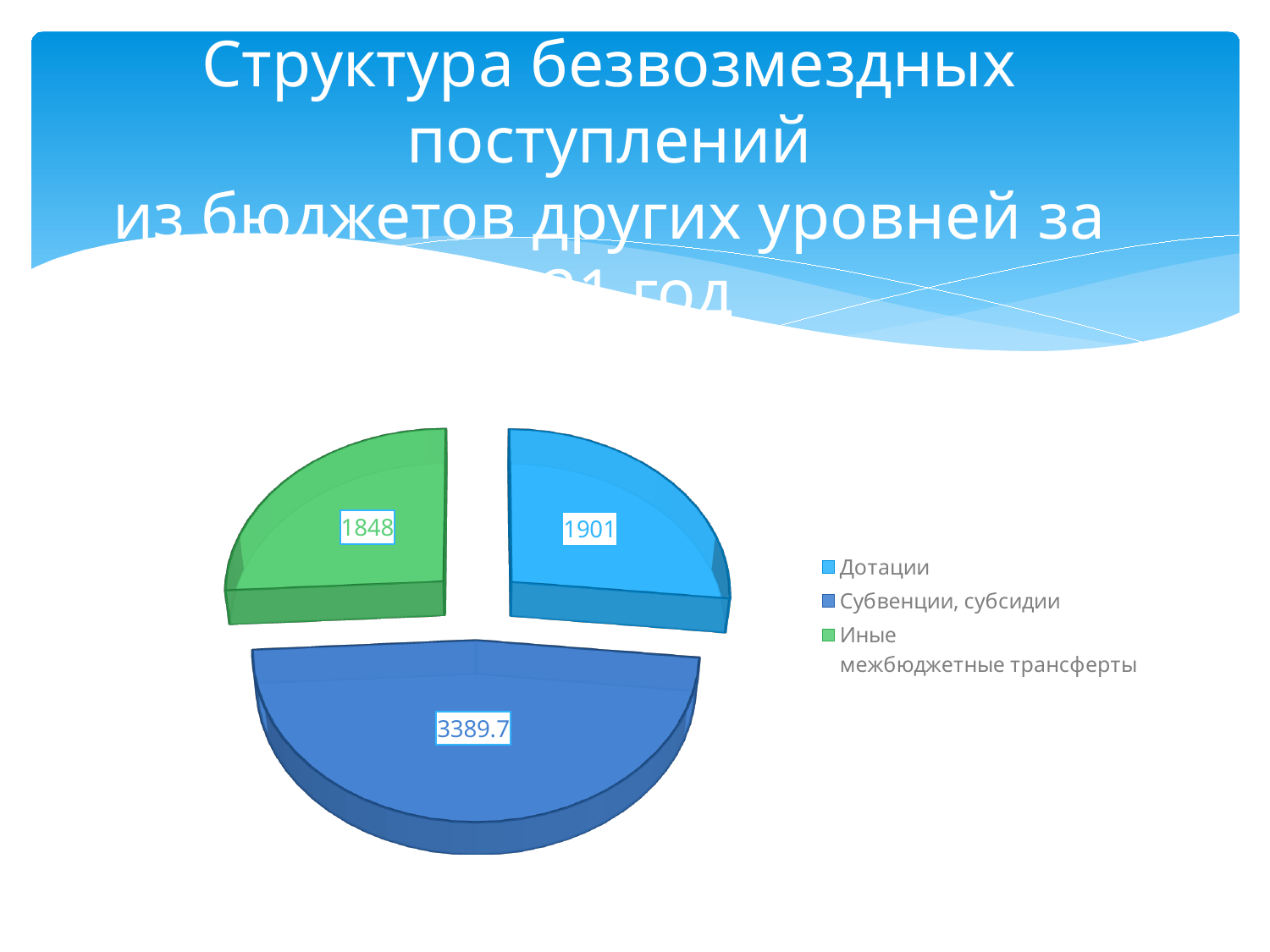
How many slices does the pie chart have? 3 How many entries does the legend list? 3 What is the value for Иные межбюджетные трансферты? 1848 Which category has the smallest slice of the pie? Иные межбюджетные трансферты What is the value for Дотации? 1901 Which category has the largest slice of the pie? Субвенции, субсидии What is the difference between the values for Субвенции, субсидии and Дотации? 1488.7 What is the value for Субвенции, субсидии? 3389.7 Which is larger, the value for Дотации or the value for Иные межбюджетные трансферты? Дотации What colour is the slice for Иные межбюджетные трансферты? Green What kind of chart is shown on the slide? Pie chart What is the difference between the values for Дотации and Иные межбюджетные трансферты? 53